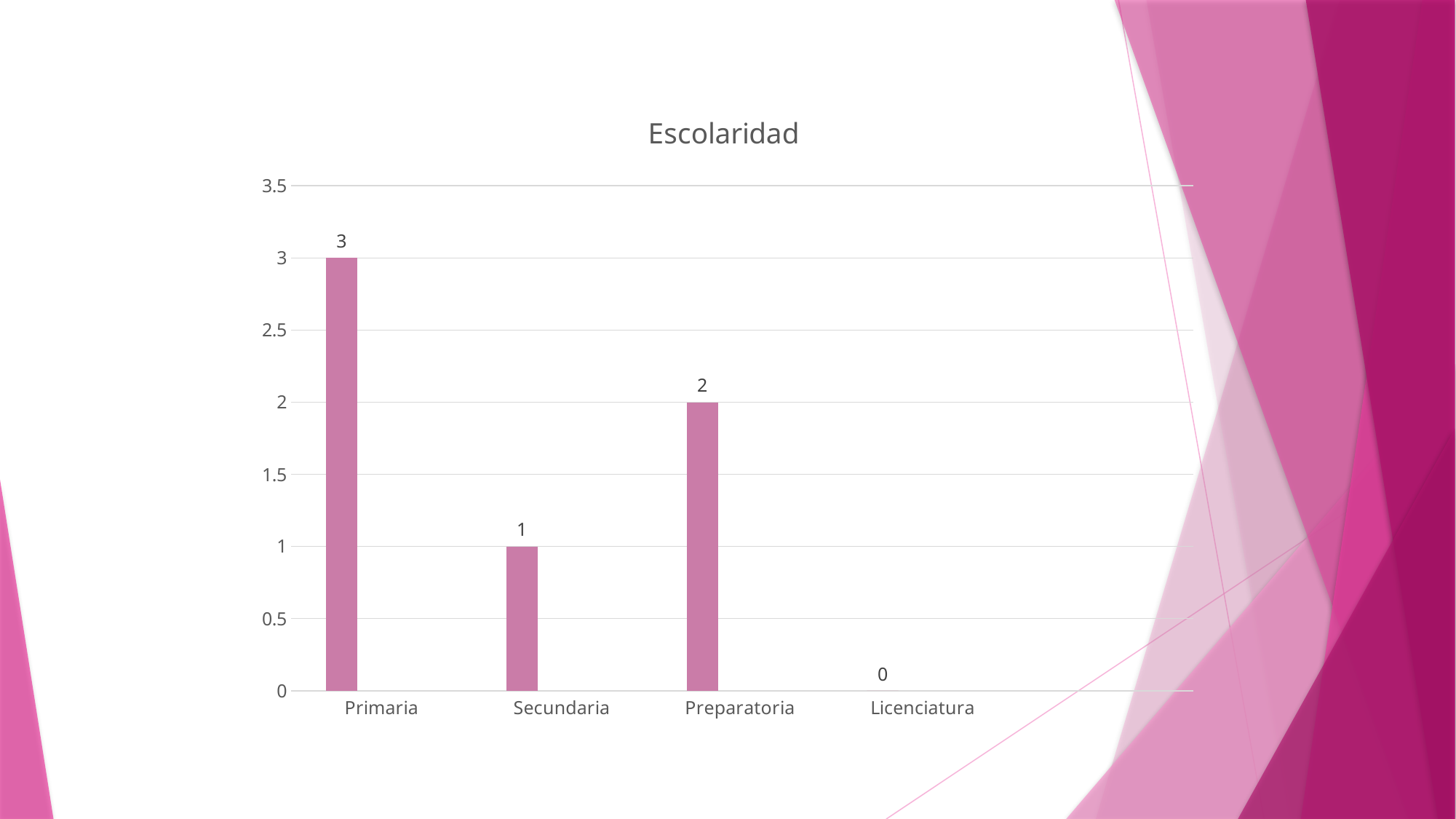
What is the value for Preparatoria? 2 Which category has the highest value? Primaria What is the title of the chart? Escolaridad What is the value for Licenciatura? 0 Which category has the lowest value? Licenciatura What kind of chart is shown? bar chart Which is larger, the value for Secundaria or the value for Preparatoria? Preparatoria What is the value for Primaria? 3 Is the value for Primaria greater or less than 2.5? greater How many categories are shown on the x axis? 4 What is the difference between the values for Primaria and Preparatoria? 1 What is the value for Secundaria? 1